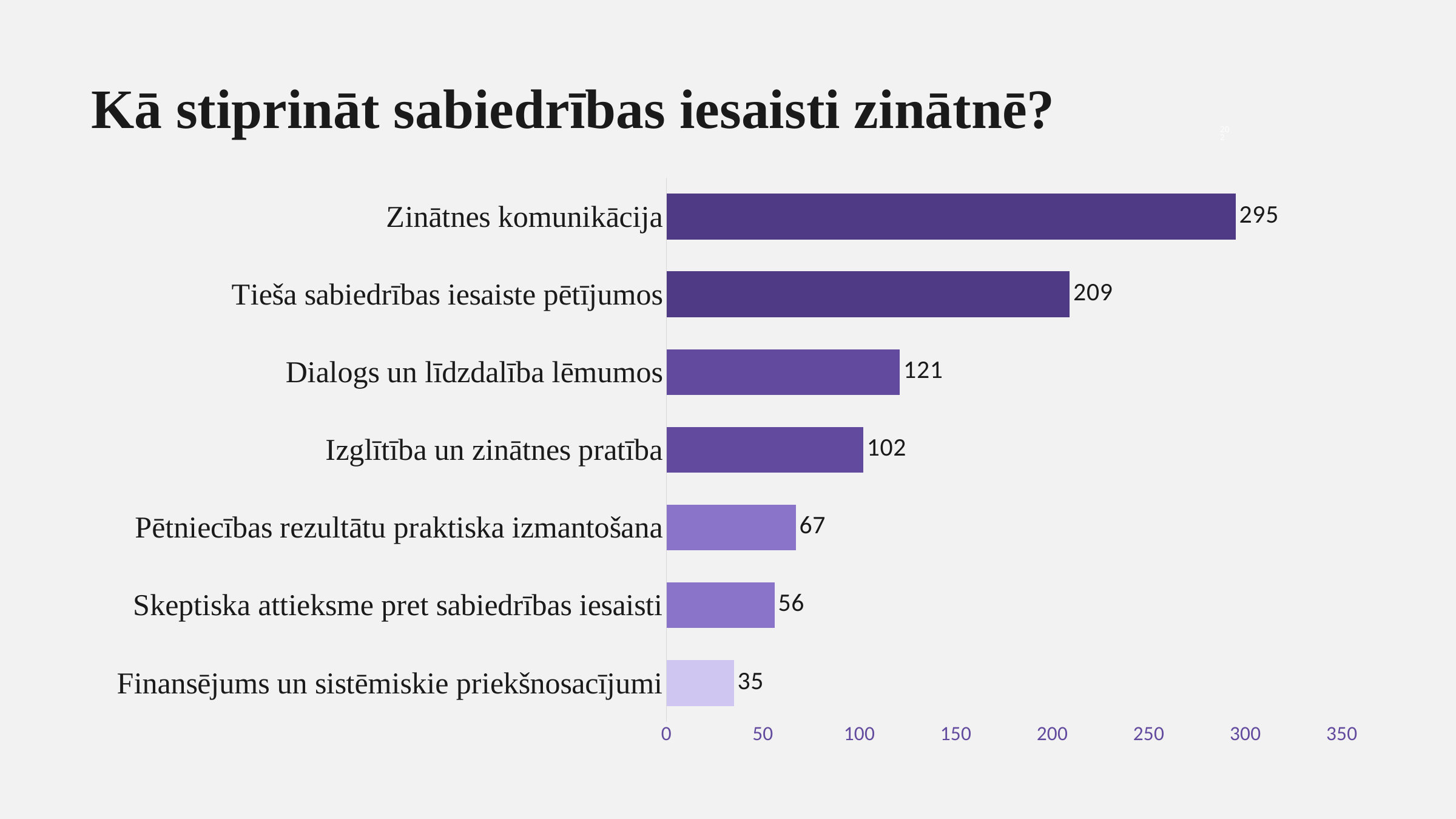
Which category has the highest value? Zinātnes komunikācija What is the difference between the values for Pētniecības rezultātu praktiska izmantošana and Skeptiska attieksme pret sabiedrības iesaisti? 11 What is the value for Dialogs un līdzdalība lēmumos? 121 Which category has the lowest value? Finansējums un sistēmiskie priekšnosacījumi What is the value for Zinātnes komunikācija? 295 What is the title of the slide? Kā stiprināt sabiedrības iesaisti zinātnē? What is the difference between the values for Zinātnes komunikācija and Tieša sabiedrības iesaiste pētījumos? 86 What kind of chart is shown on the slide? bar chart Is the value for Tieša sabiedrības iesaiste pētījumos greater or less than 200? greater What is the value for Finansējums un sistēmiskie priekšnosacījumi? 35 Which is larger: the value for Izglītība un zinātnes pratība or the value for Dialogs un līdzdalība lēmumos? Dialogs un līdzdalība lēmumos How many categories are shown in the chart? 7